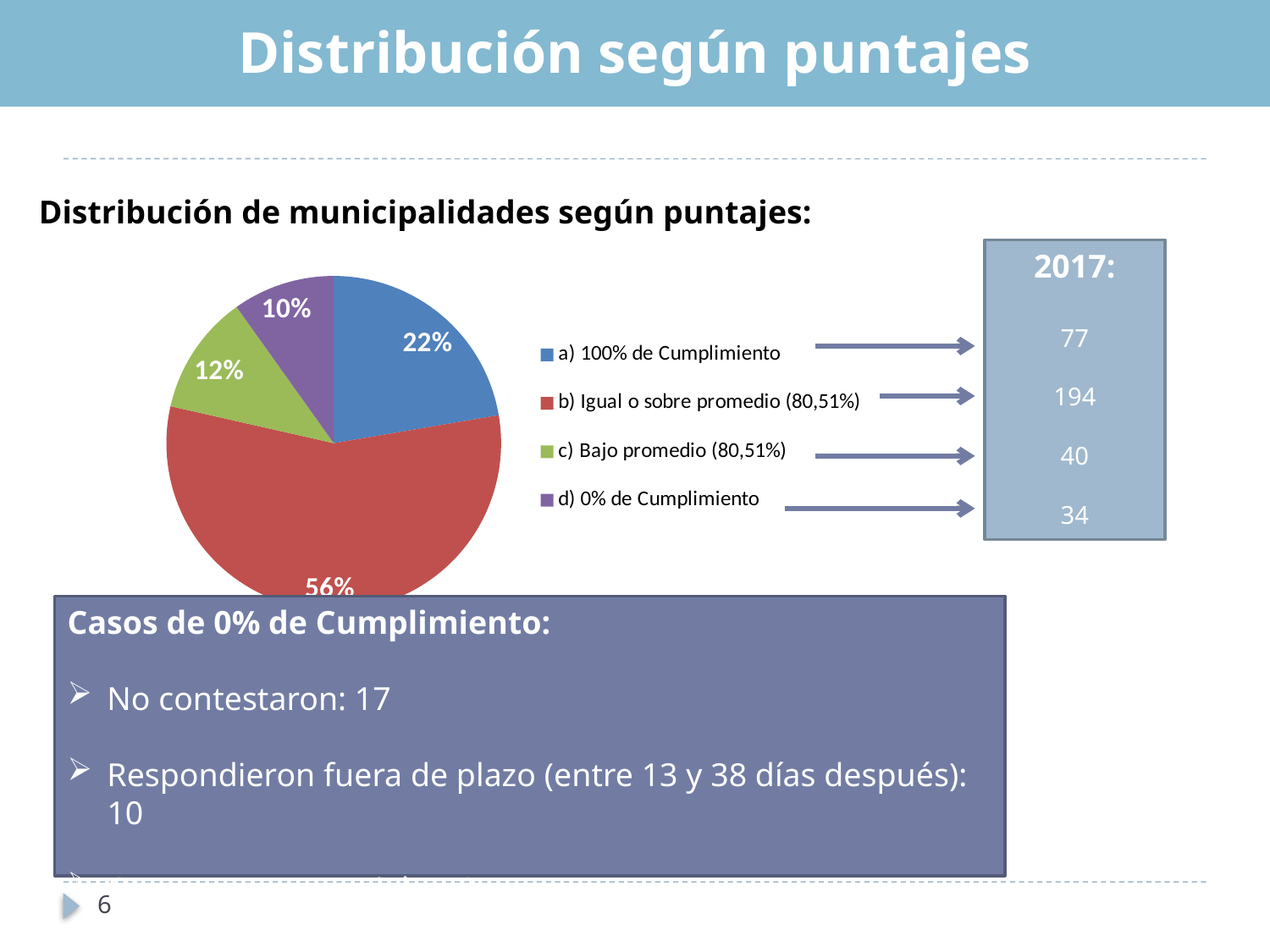
What type of chart is shown on the slide? Pie chart Which category has the largest share of the pie? b) Igual o sobre promedio (80,51%) What colour is the slice for 'b) Igual o sobre promedio (80,51%)'? Red Which category has the smallest share of the pie? d) 0% de Cumplimiento What percentage of the pie corresponds to 'a) 100% de Cumplimiento'? 22% What percentage of the pie corresponds to 'b) Igual o sobre promedio (80,51%)'? 56% What percentage of the pie corresponds to 'c) Bajo promedio (80,51%)'? 12% How many categories does the pie chart have? 4 What colour is the slice for 'a) 100% de Cumplimiento'? Blue Which is larger: the share for 'c) Bajo promedio (80,51%)' or the share for 'd) 0% de Cumplimiento'? c) Bajo promedio (80,51%) What percentage of the pie corresponds to 'd) 0% de Cumplimiento'? 10% What is the difference in percentage points between 'b) Igual o sobre promedio (80,51%)' and 'a) 100% de Cumplimiento'? 34 percentage points